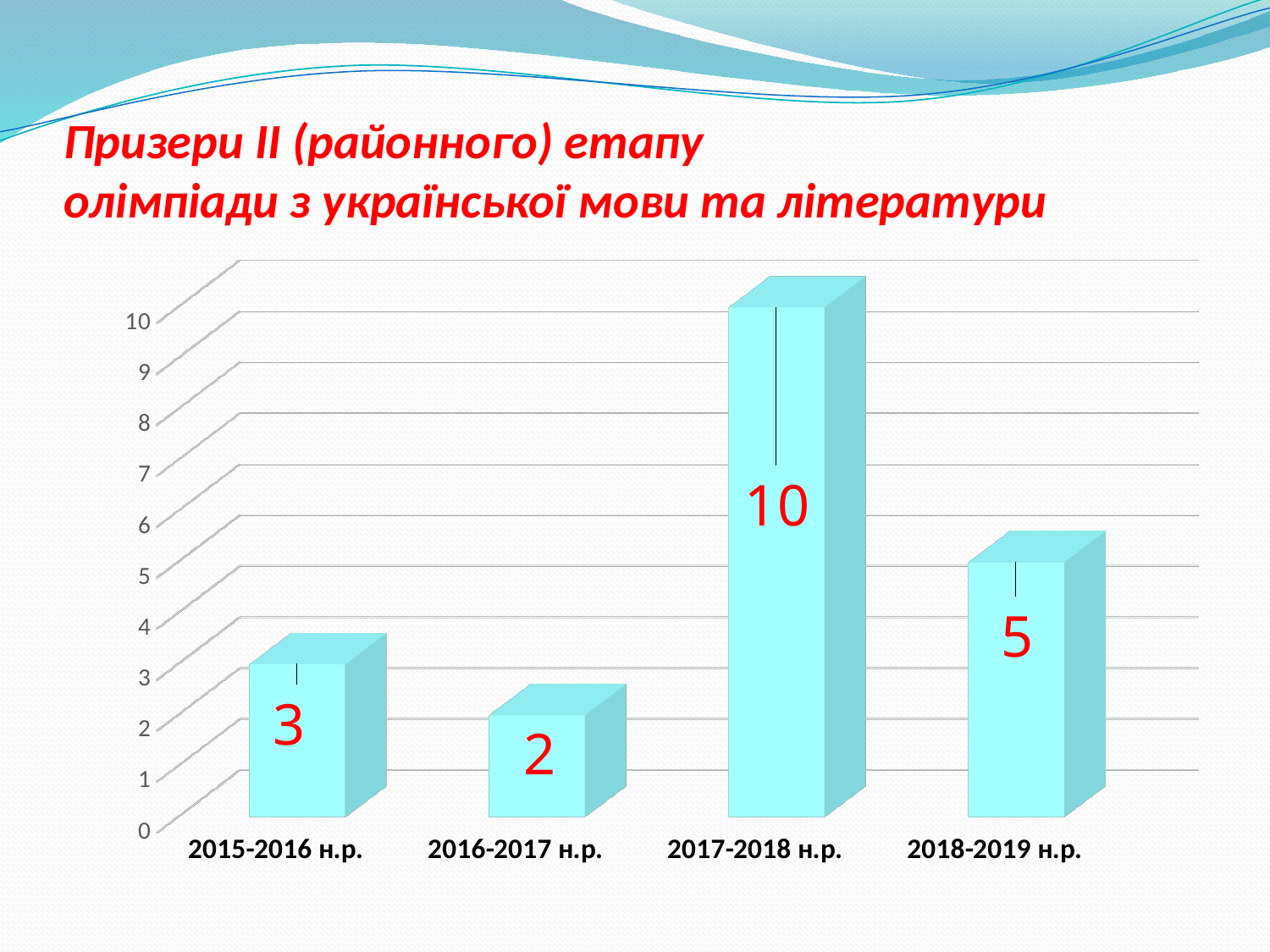
Which is larger, the value for 2018-2019 н.р. or the value for 2015-2016 н.р.? 2018-2019 н.р. What kind of chart is shown on the slide? bar chart Which school year has the highest value? 2017-2018 н.р. How many school years are shown on the x axis? 4 What is the title of the chart on the slide? Призери ІІ (районного) етапу олімпіади з української мови та літератури What is the difference between the values for 2017-2018 н.р. and 2018-2019 н.р.? 5 What is the value for 2015-2016 н.р.? 3 Which school year has the lowest value? 2016-2017 н.р. What is the value for 2016-2017 н.р.? 2 What is the difference between the values for 2015-2016 н.р. and 2016-2017 н.р.? 1 What is the value for 2018-2019 н.р.? 5 What is the value for 2017-2018 н.р.? 10